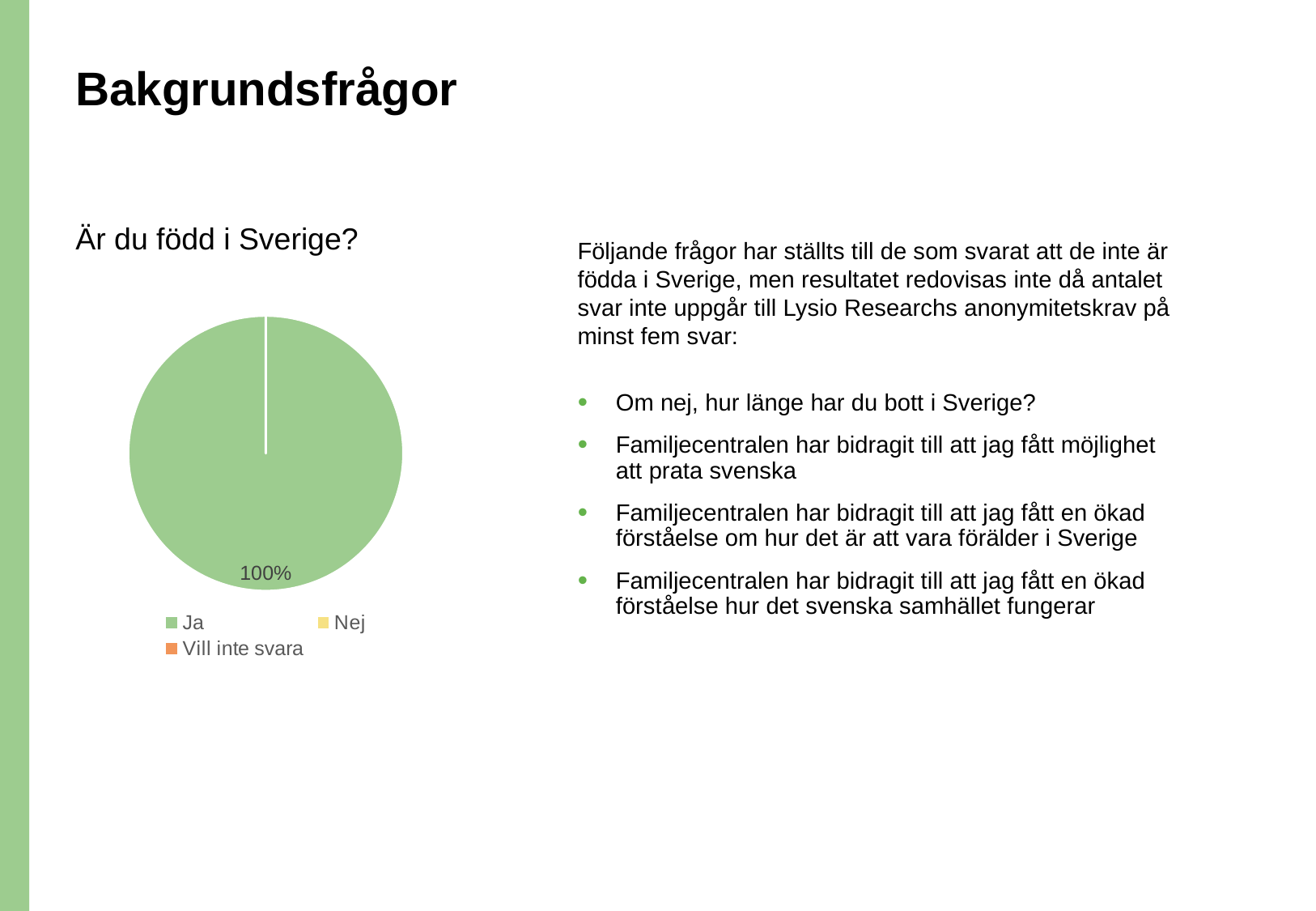
Which category has the largest slice of the pie? Ja What kind of chart is shown under "Är du född i Sverige?"? pie chart How many entries does the legend of the pie chart list? 3 How many visible slices does the pie chart have? 1 Is the share for "Ja" greater or less than 50%? greater What is the data label printed on the pie chart? 100% What is the title of the pie chart? Är du född i Sverige? What colour is the "Ja" slice in the pie chart? green What share of the pie does "Ja" have? 100% Which is larger in the pie chart, the share for "Ja" or the share for "Nej"? Ja